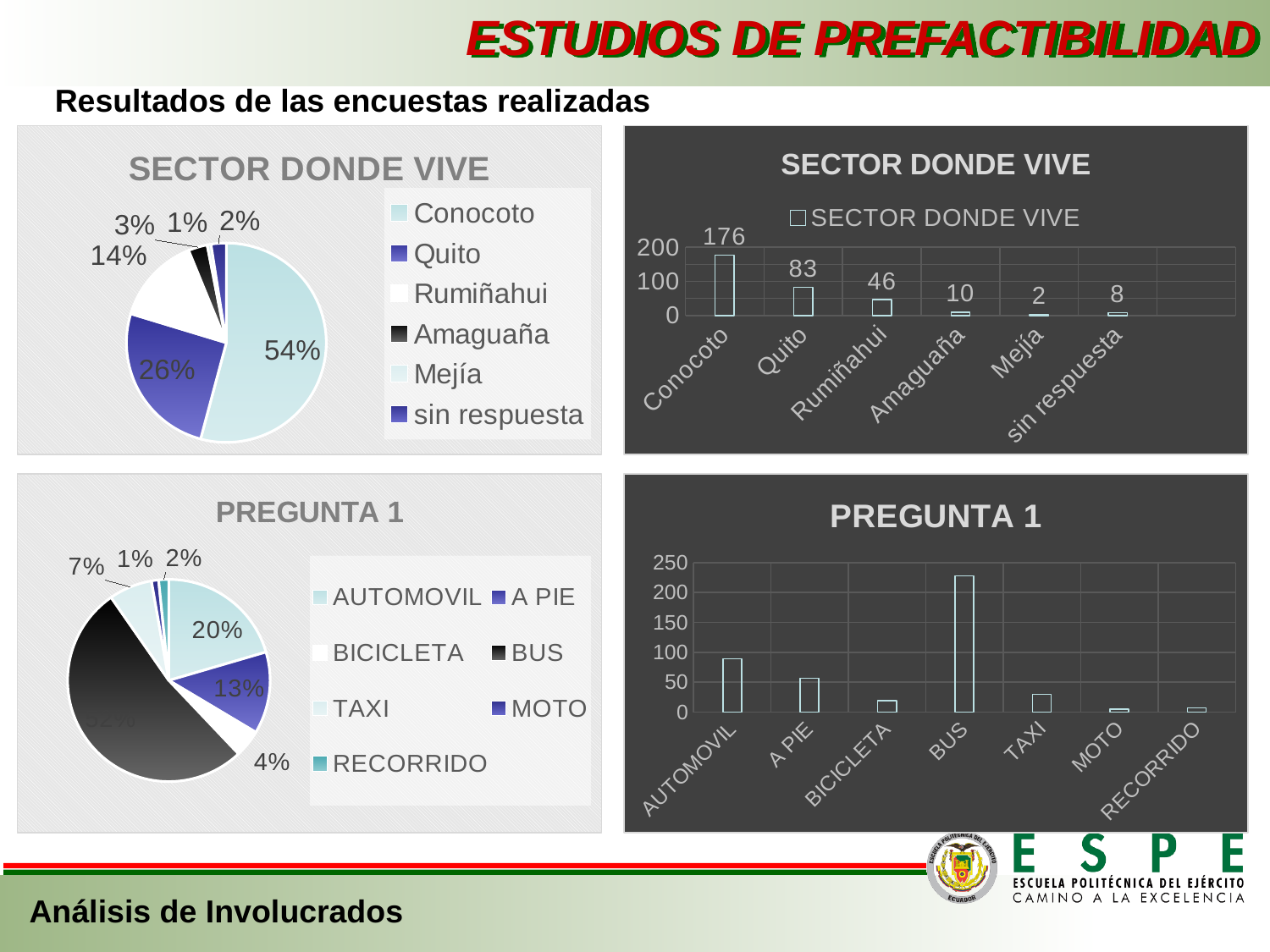
In the top-right bar chart titled SECTOR DONDE VIVE, which category has the lowest value? Mejía In the top-right bar chart titled SECTOR DONDE VIVE, how many categories are shown on the x axis? 6 In the bottom-right chart titled PREGUNTA 1, which category has the highest value? BUS What kind of chart is the bottom-right chart titled PREGUNTA 1? bar chart In the bottom-left pie chart titled PREGUNTA 1, how many entries does the legend list? 7 In the top-right bar chart titled SECTOR DONDE VIVE, what is the difference between the values for Conocoto and Quito? 93 In the top-left pie chart titled SECTOR DONDE VIVE, what share does Conocoto have? 54% In the top-right bar chart titled SECTOR DONDE VIVE, what is the value for Conocoto? 176 In the bottom-right chart titled PREGUNTA 1, is the value for AUTOMOVIL greater or less than 50? greater In the bottom-left pie chart titled PREGUNTA 1, what share does AUTOMOVIL have? 20% In the top-left pie chart titled SECTOR DONDE VIVE, what share does Quito have? 26% In the top-right bar chart titled SECTOR DONDE VIVE, what is the value for Rumiñahui? 46